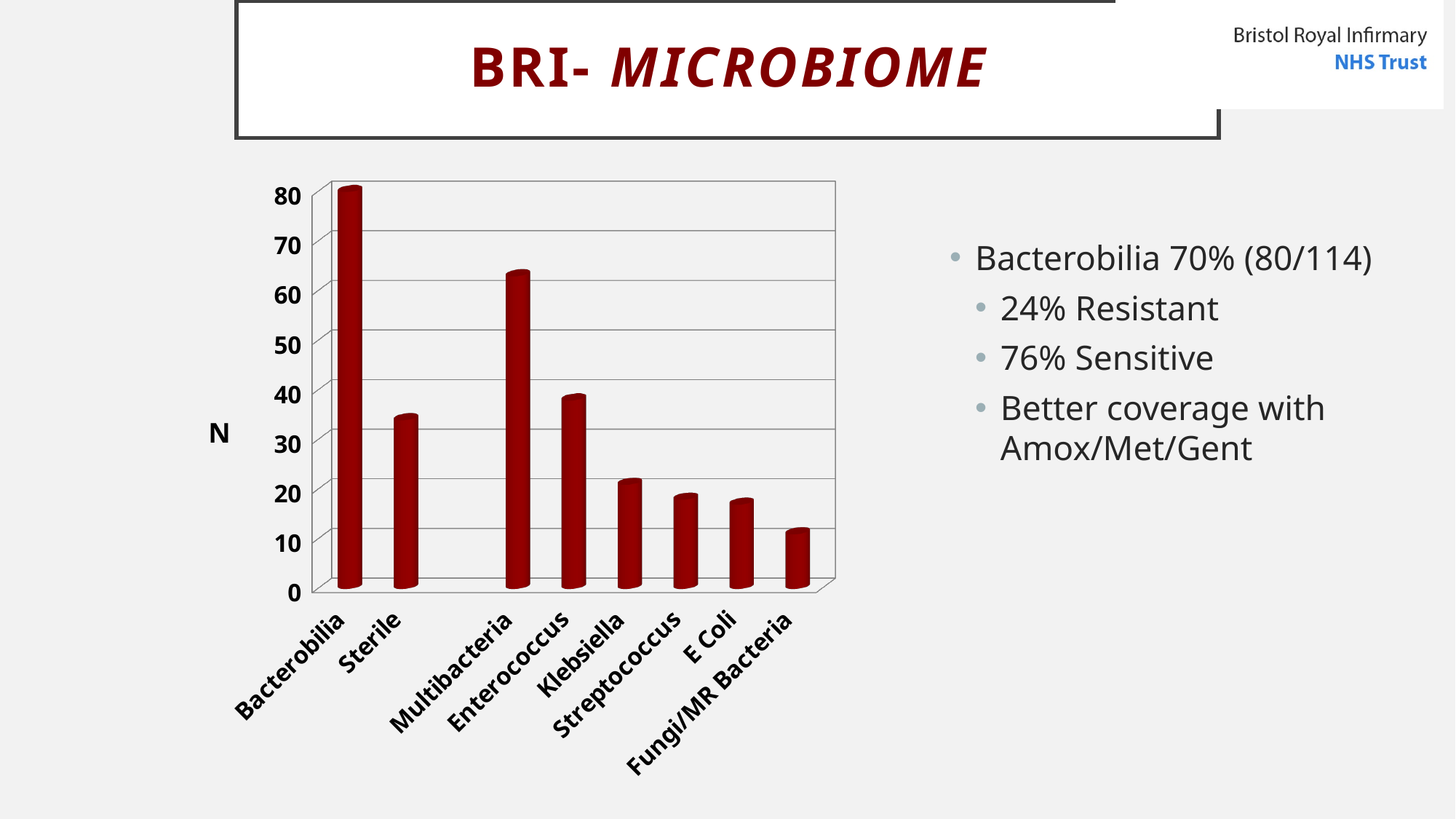
Is the value for Multibacteria greater or less than 60? greater How many categories are plotted on the x axis of the chart? 8 What kind of chart is shown on the slide? bar chart What is the value for Bacterobilia in the chart? 80 Which category has the lowest bar in the chart? Fungi/MR Bacteria Which category has the highest bar in the chart? Bacterobilia What is the label on the vertical axis of the chart? N Which is larger, the value for Multibacteria or the value for Enterococcus? Multibacteria Is the value for E Coli greater or less than 20? less Is the value for Sterile greater or less than 30? greater What is the title of the slide containing the chart? BRI- MICROBIOME